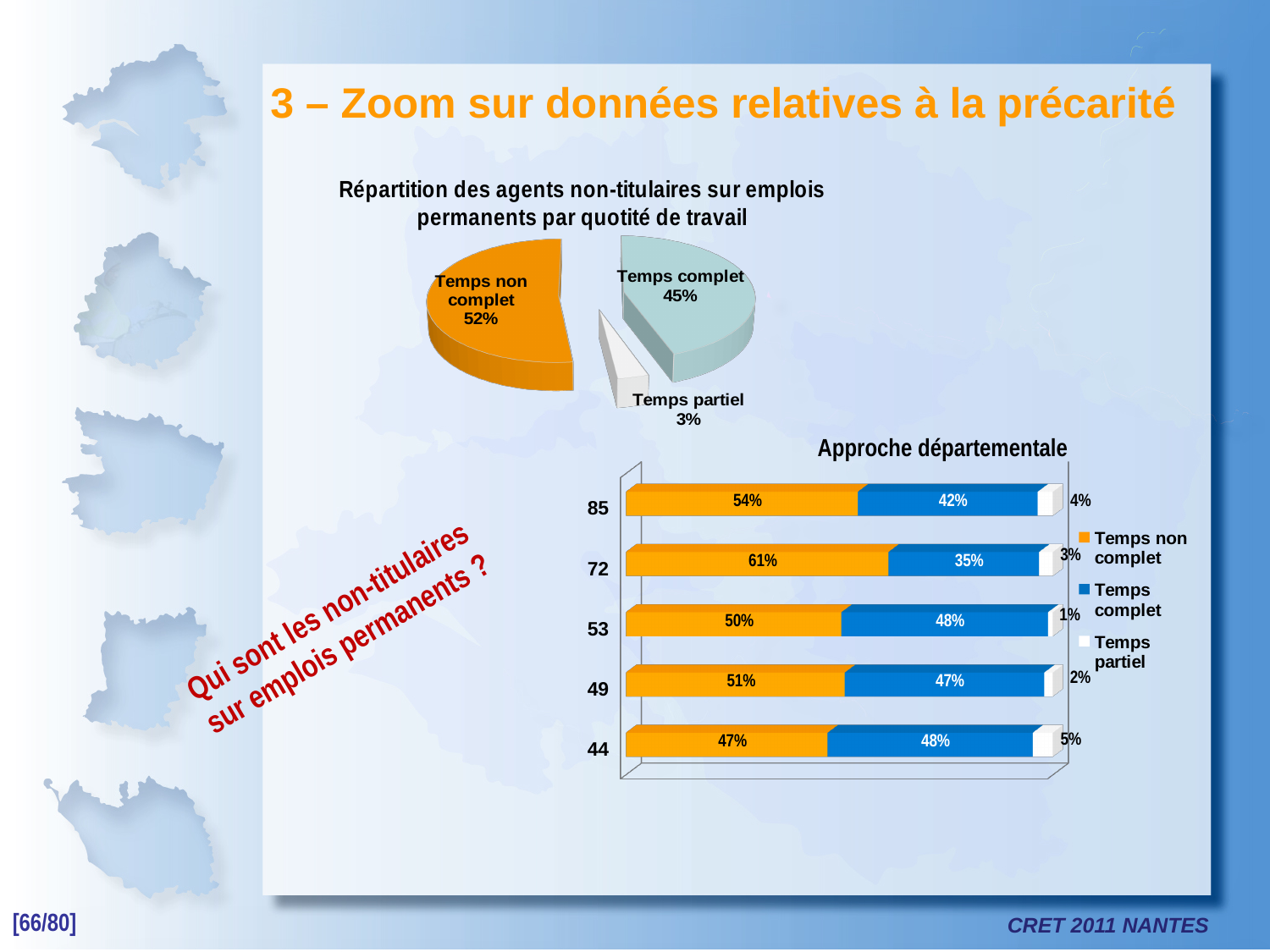
In the 'Approche départementale' chart, how many series does the legend list? 3 In the 'Approche départementale' chart, which department has the highest 'Temps non complet' value? 72 In the 'Approche départementale' chart, which department has the lowest 'Temps partiel' value? 53 In the pie chart 'Répartition des agents non-titulaires sur emplois permanents par quotité de travail', what is the difference between the 'Temps non complet' and 'Temps complet' shares? 7% In the 'Approche départementale' chart, is the 'Temps complet' value for department 85 larger or smaller than for department 72? Larger In the pie chart 'Répartition des agents non-titulaires sur emplois permanents par quotité de travail', how many slices are there? 3 In the pie chart 'Répartition des agents non-titulaires sur emplois permanents par quotité de travail', what share is 'Temps non complet'? 52% In the 'Approche départementale' chart, what is the 'Temps partiel' value for department 44? 5% In the 'Approche départementale' chart, what is the 'Temps non complet' value for department 72? 61% In the pie chart 'Répartition des agents non-titulaires sur emplois permanents par quotité de travail', which category has the smallest slice? Temps partiel In the 'Approche départementale' chart, what is the 'Temps complet' value for department 53? 48% What kind of chart is 'Approche départementale'? Stacked bar chart